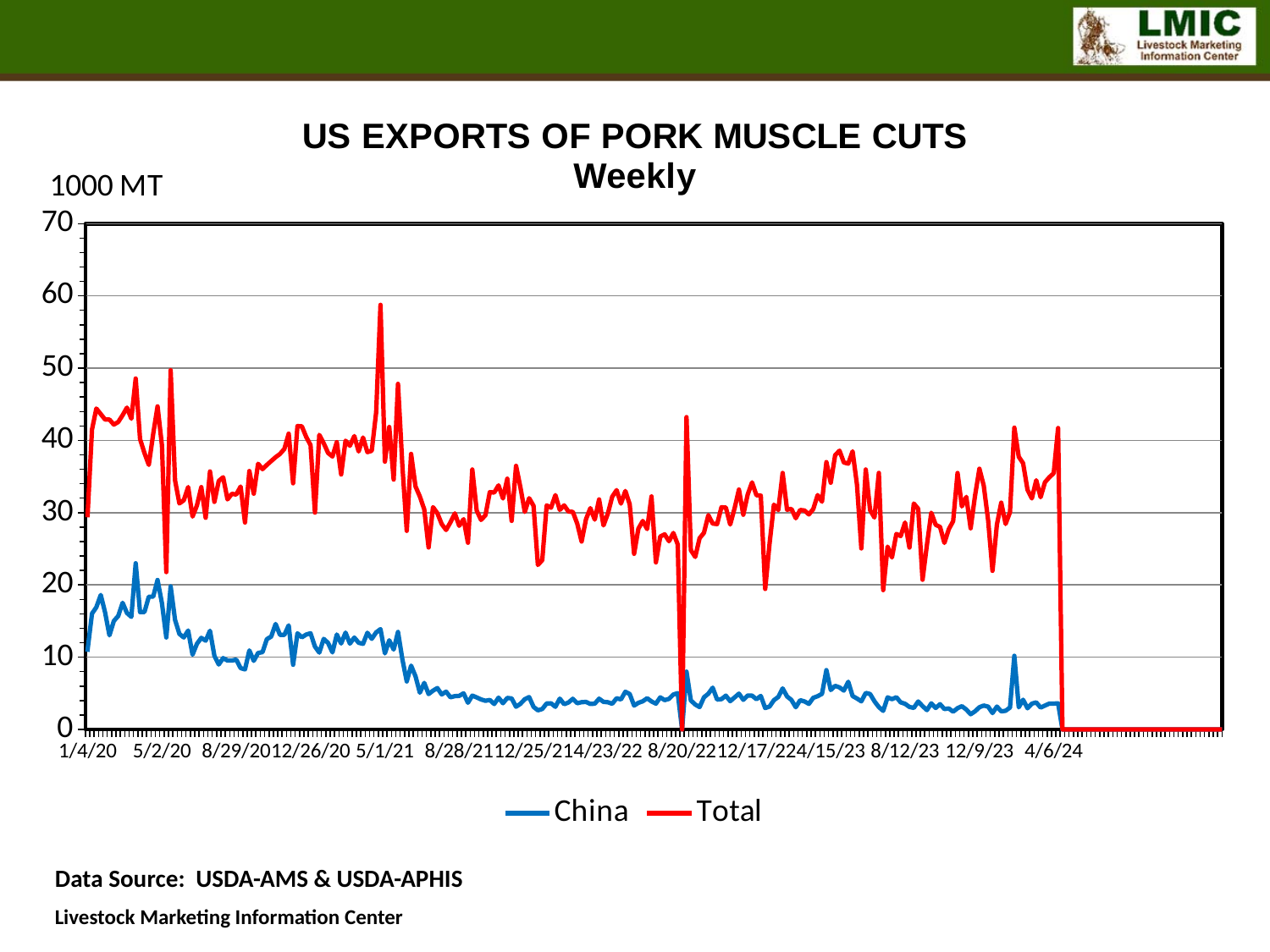
What kind of chart is shown on the slide? line chart Which series has the higher values throughout the chart, China or Total? Total Is the value for China around 12/9/23 greater or less than 10? less How many series does the legend list? 2 Is the highest value of the China series greater or less than 20? greater What is the title of the chart? US EXPORTS OF PORK MUSCLE CUTS Weekly Is the highest value of the Total series greater or less than 50? greater Does the China series generally rise or fall from 2020 to 2024? fall What unit is shown on the y axis of the chart? 1000 MT Which series is drawn in red? Total